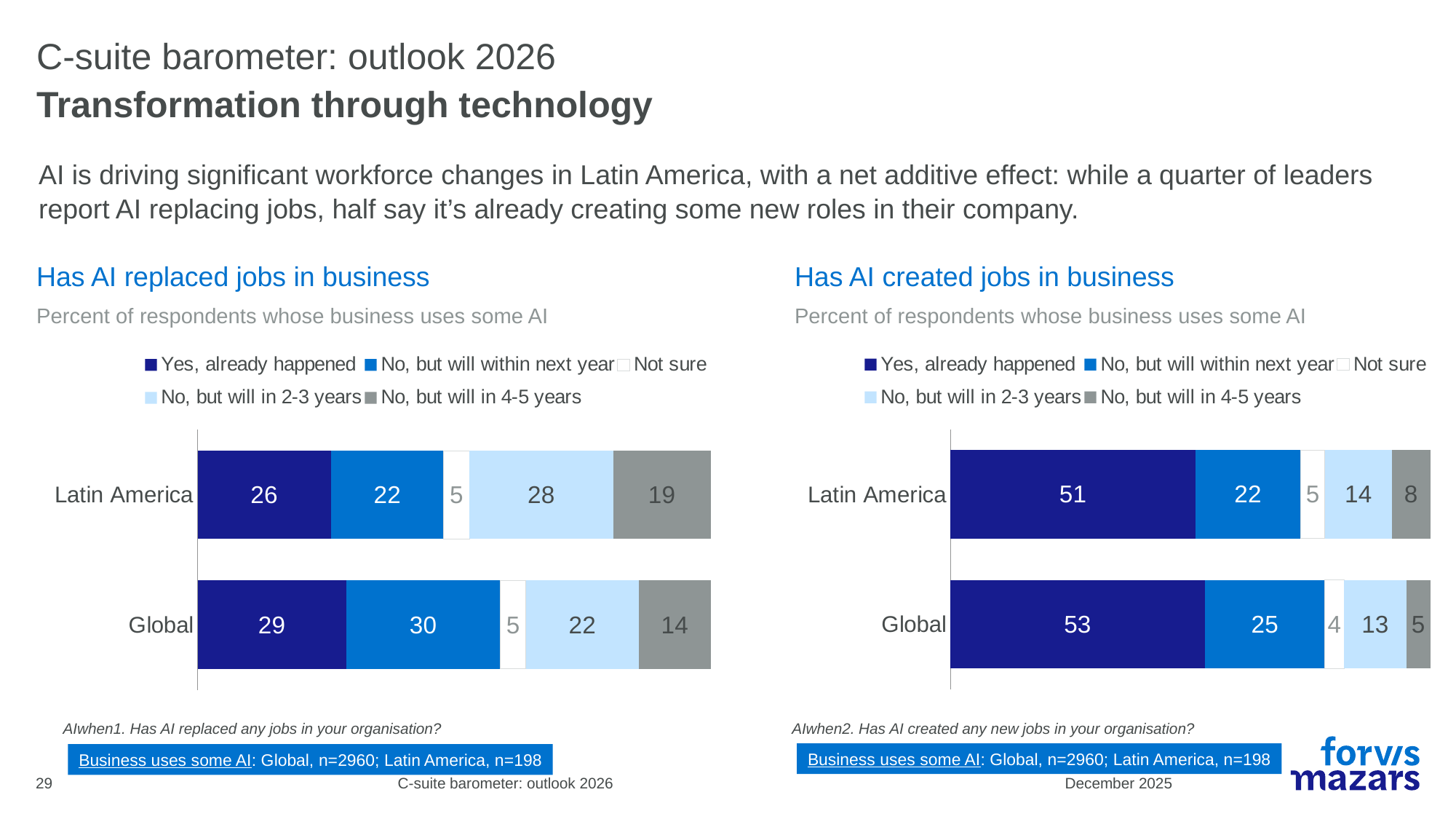
In the 'Has AI replaced jobs in business' chart, what is the difference between the 'No, but will in 4-5 years' values for Latin America and Global? 5 In the 'Has AI replaced jobs in business' chart, what is the total of the Latin America bar? 100 In the 'Has AI created jobs in business' chart, which is larger for 'Yes, already happened': Latin America or Global? Global In the 'Has AI created jobs in business' chart, what is the value for 'Yes, already happened' for Global? 53 In the 'Has AI replaced jobs in business' chart, what is the value for 'No, but will in 2-3 years' for Latin America? 28 In the 'Has AI replaced jobs in business' chart, what is the value for 'Yes, already happened' for Latin America? 26 How many categories are shown in the 'Has AI created jobs in business' chart? 2 In the 'Has AI created jobs in business' chart, what is the value for 'No, but will in 4-5 years' for Latin America? 8 In the 'Has AI created jobs in business' chart, which segment is the smallest for Global? Not sure What kind of chart is the 'Has AI replaced jobs in business' chart? Stacked bar chart How many series does the legend of the 'Has AI created jobs in business' chart list? 5 In the 'Has AI replaced jobs in business' chart, which segment is the largest for Global? No, but will within next year